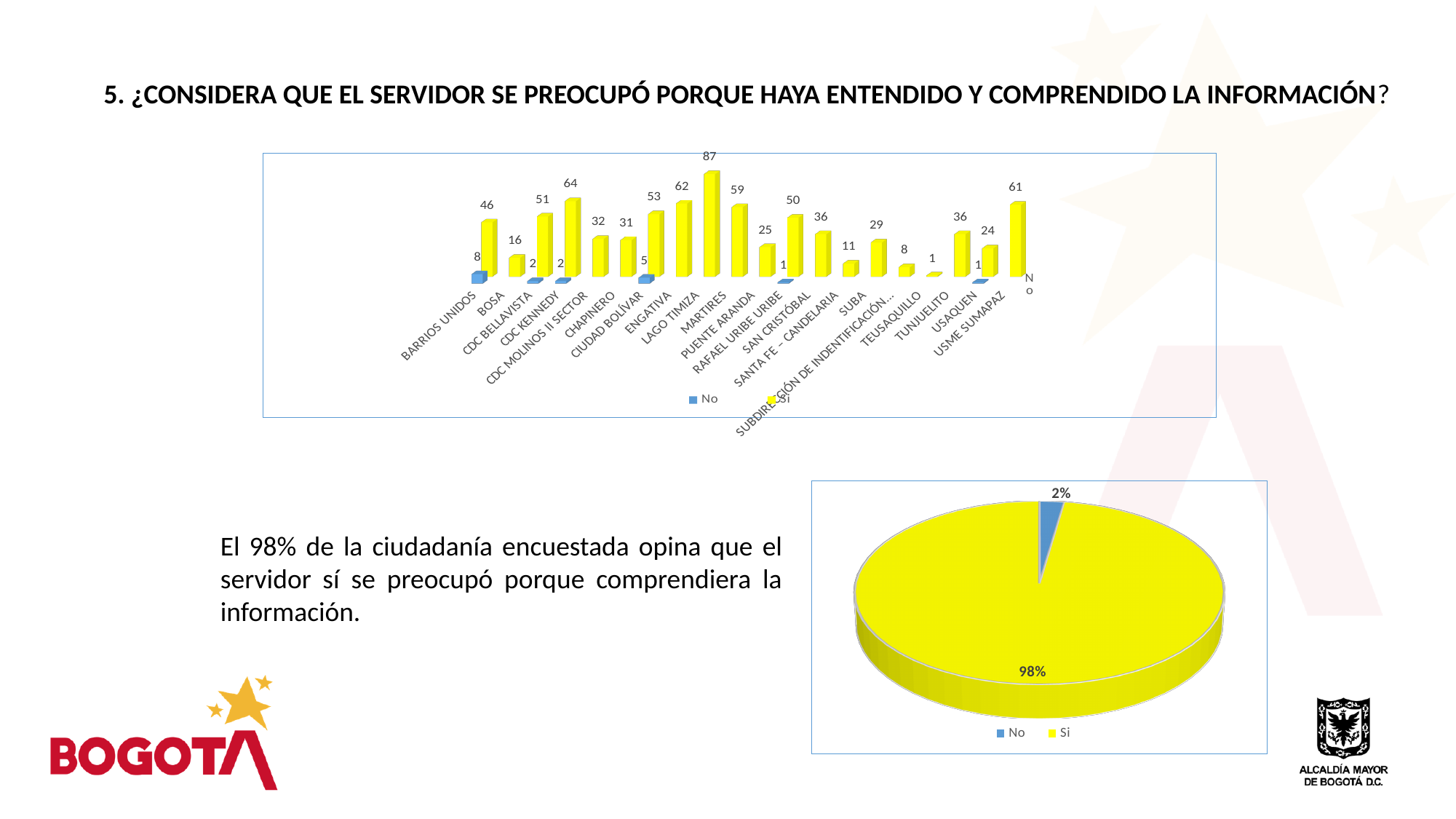
In the top bar chart, what is the "No" value for BARRIOS UNIDOS? 8 What kind of chart is shown at the bottom right of the slide? Pie chart How many series does the legend of the pie chart list? 2 What kind of chart is shown at the top of the slide? Bar chart In the top bar chart, what is the "Si" value for LAGO TIMIZA? 87 In the top bar chart, what is the difference between the "Si" values for LAGO TIMIZA and USME SUMAPAZ? 26 In the top bar chart, which colour represents the "Si" series? Yellow In the pie chart, what percentage of respondents answered "No"? 2% In the top bar chart, what is the "Si" value for CDC KENNEDY? 64 In the top bar chart, which category has the highest "Si" value? LAGO TIMIZA In the pie chart, which slice is larger, "No" or "Si"? Si In the pie chart, what percentage of respondents answered "Si"? 98%